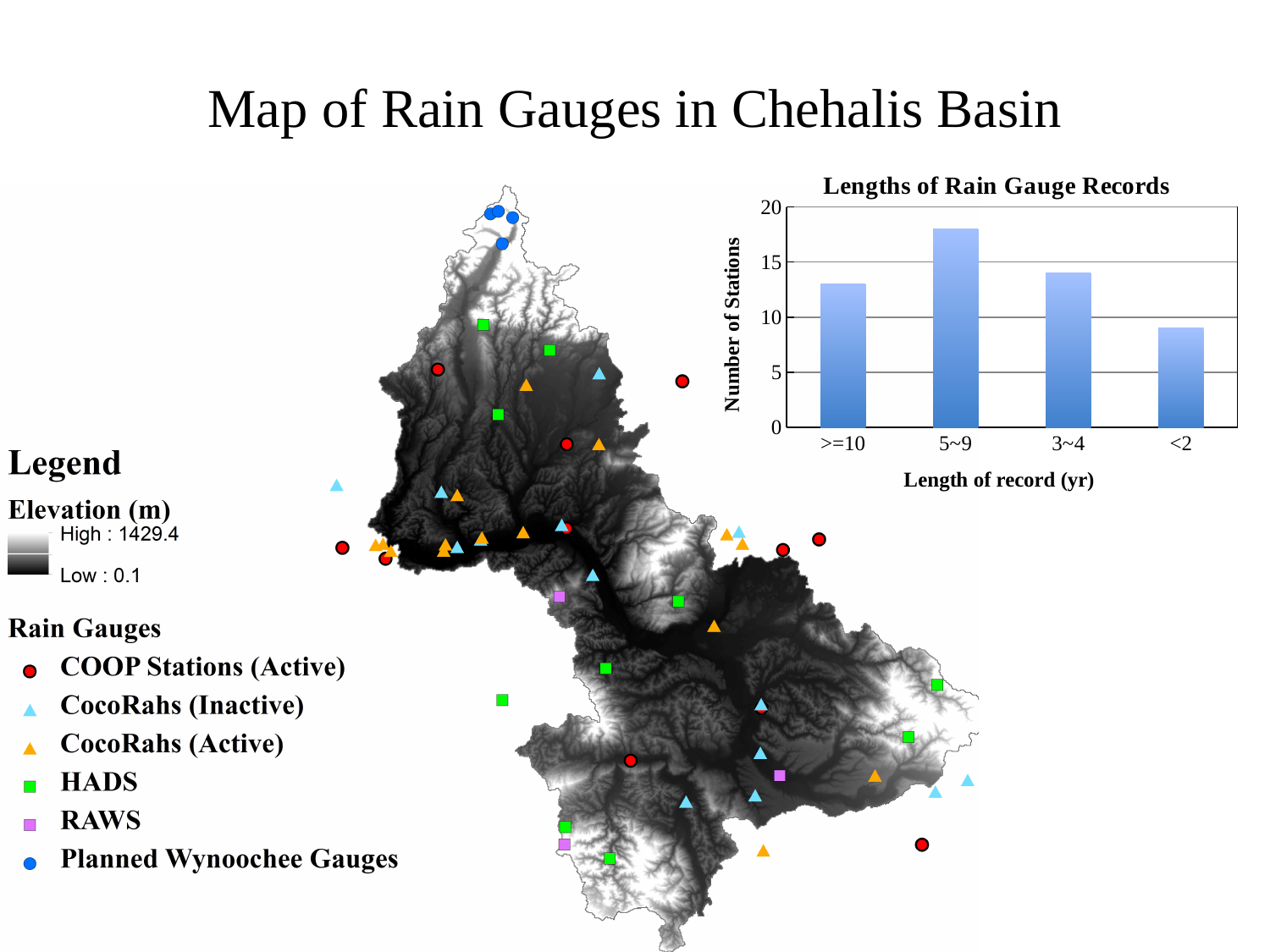
In the "Lengths of Rain Gauge Records" chart, which has more stations: 5~9 or <2? 5~9 In the "Lengths of Rain Gauge Records" chart, which has more stations: >=10 or <2? >=10 In the "Lengths of Rain Gauge Records" chart, is the number of stations for 3~4 greater or less than 10? greater In the "Lengths of Rain Gauge Records" chart, is the number of stations for 5~9 greater or less than 20? less In the "Lengths of Rain Gauge Records" chart, is the number of stations for <2 greater or less than 5? greater In the "Lengths of Rain Gauge Records" chart, which length-of-record category has the lowest number of stations? <2 In the "Lengths of Rain Gauge Records" chart, which length-of-record category has the highest number of stations? 5~9 What is the label of the vertical axis in the "Lengths of Rain Gauge Records" chart? Number of Stations What kind of chart is "Lengths of Rain Gauge Records"? bar chart How many length-of-record categories are shown in the "Lengths of Rain Gauge Records" chart? 4